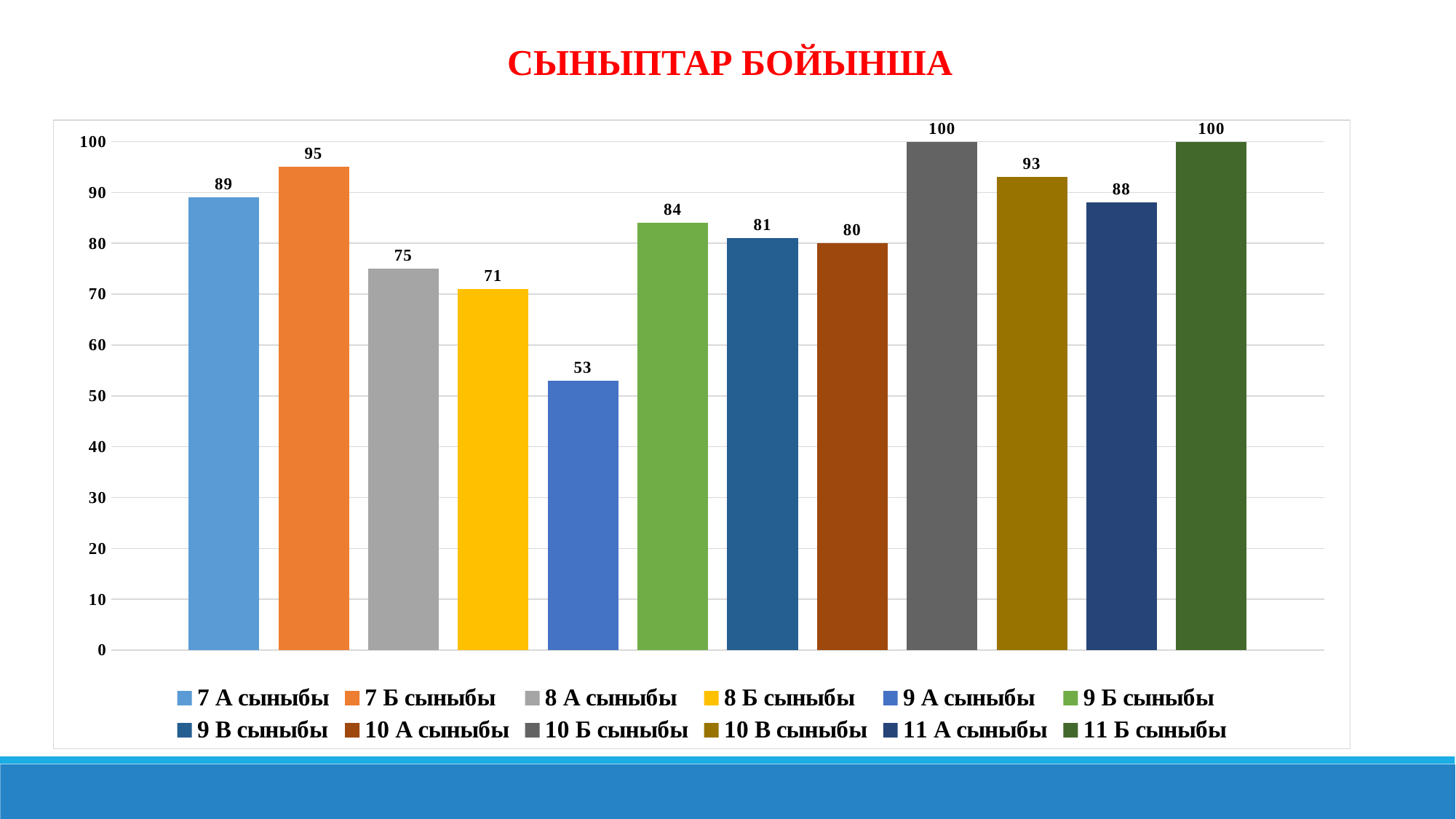
How many entries does the legend list? 12 Which class has the lowest value? 9 А сыныбы What is the difference between the values for 10 Б сыныбы and 9 А сыныбы? 47 Which is larger, the value for 9 Б сыныбы or the value for 9 В сыныбы? 9 Б сыныбы What is the difference between the values for 7 Б сыныбы and 7 А сыныбы? 6 What kind of chart is shown on the slide? Bar chart What is the value for 8 Б сыныбы? 71 Which two classes share the highest value of 100? 10 Б сыныбы and 11 Б сыныбы How many bars are plotted on the chart? 12 What is the value for 7 Б сыныбы? 95 What is the value for 9 А сыныбы? 53 What is the value for 10 В сыныбы? 93